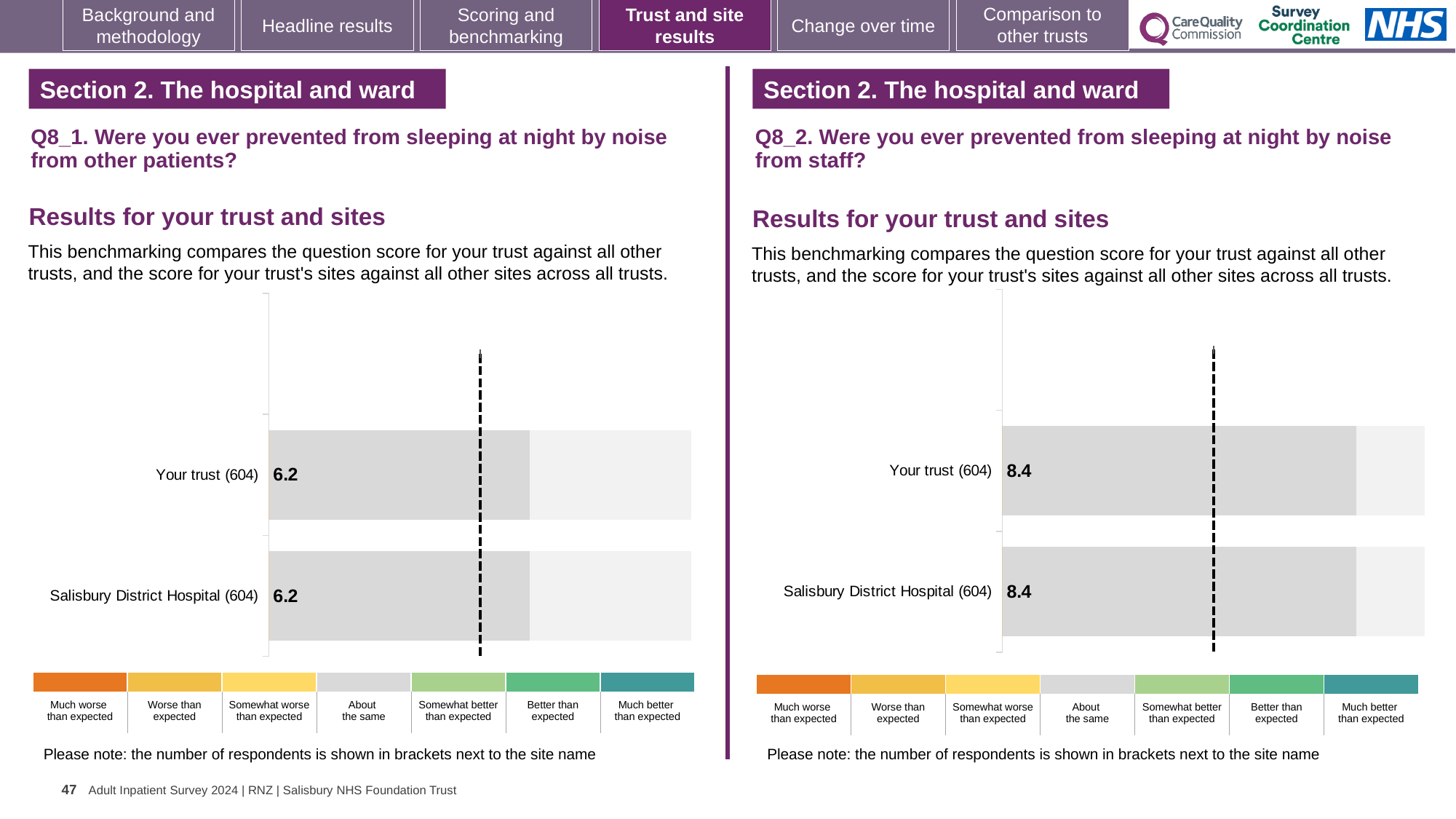
How many categories does the colour key below the Q8_2 chart list, from 'Much worse than expected' to 'Much better than expected'? 7 In the Q8_1 chart, how many respondents are shown in brackets next to Your trust? 604 How many bars are plotted in the Q8_2 chart (noise from staff)? 2 In the Q8_1 chart (noise from other patients), what is the score for Salisbury District Hospital? 6.2 In the Q8_1 chart (noise from other patients), what is the score for Your trust? 6.2 Which chart shows a higher score for Your trust, the Q8_1 chart or the Q8_2 chart? Q8_2 What kind of chart is used in the Q8_1 chart (noise from other patients)? Bar chart In the Q8_2 chart (noise from staff), what is the score for Your trust? 8.4 What is the difference between the Your trust score in the Q8_2 chart and the Your trust score in the Q8_1 chart? 2.2 In the Q8_2 chart (noise from staff), what is the score for Salisbury District Hospital? 8.4 How many bars are plotted in the Q8_1 chart (noise from other patients)? 2